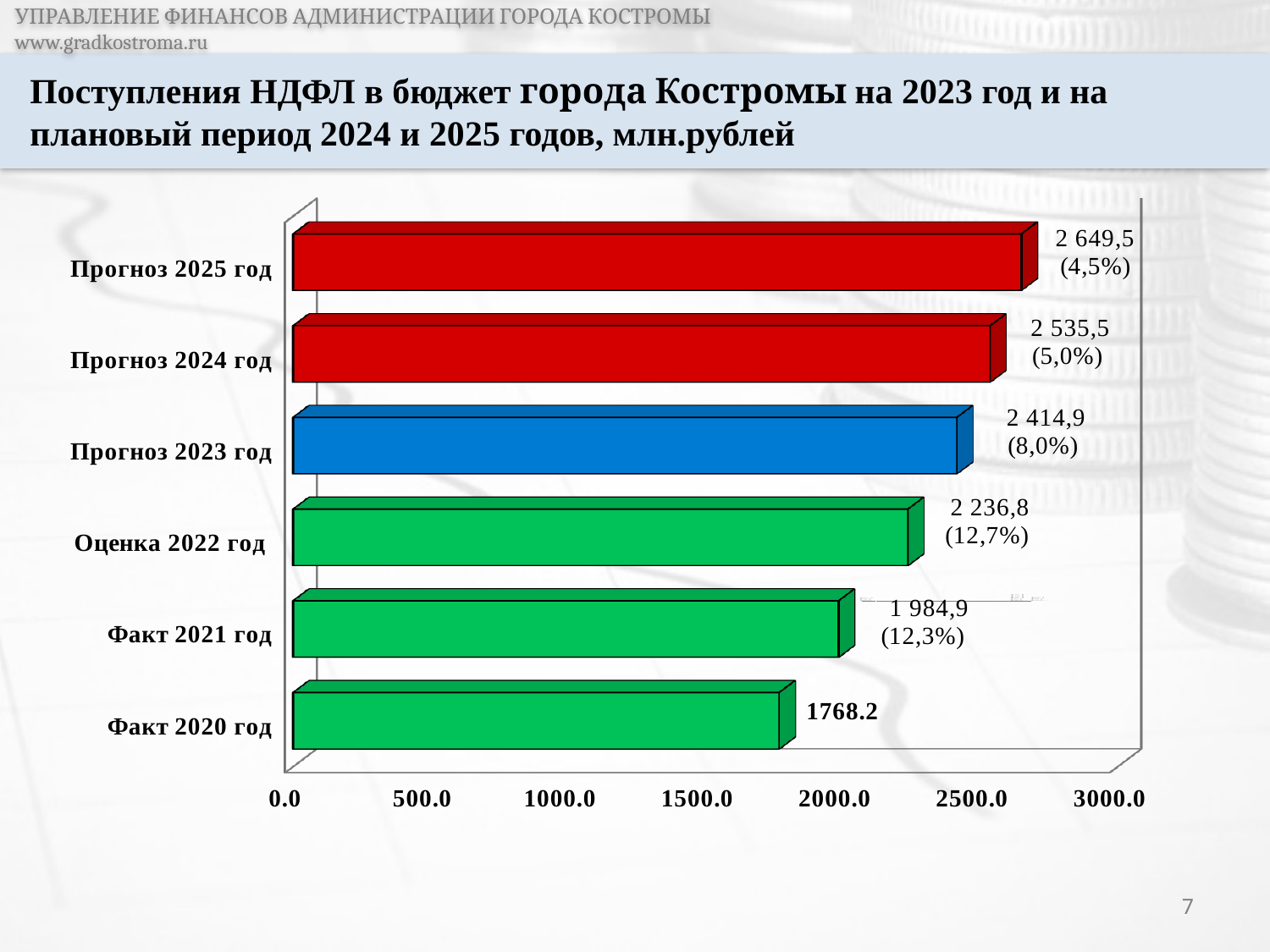
What is the difference between the values for Оценка 2022 год and Факт 2021 год? 251,9 What is the value shown for Прогноз 2025 год? 2 649,5 How many categories are shown in the chart? 6 What is the difference between the values for Прогноз 2025 год and Прогноз 2024 год? 114,0 Do the values increase or decrease going from Факт 2020 год up to Прогноз 2025 год? Increase What kind of chart is shown on the slide? Bar chart Which category has the highest value? Прогноз 2025 год What percentage is shown in parentheses next to the bar for Оценка 2022 год? 12,7% What is the value shown for Прогноз 2023 год? 2 414,9 Which category has the lowest value? Факт 2020 год What is the value shown for Факт 2020 год? 1768.2 Which is larger, the value for Прогноз 2023 год or the value for Оценка 2022 год? Прогноз 2023 год